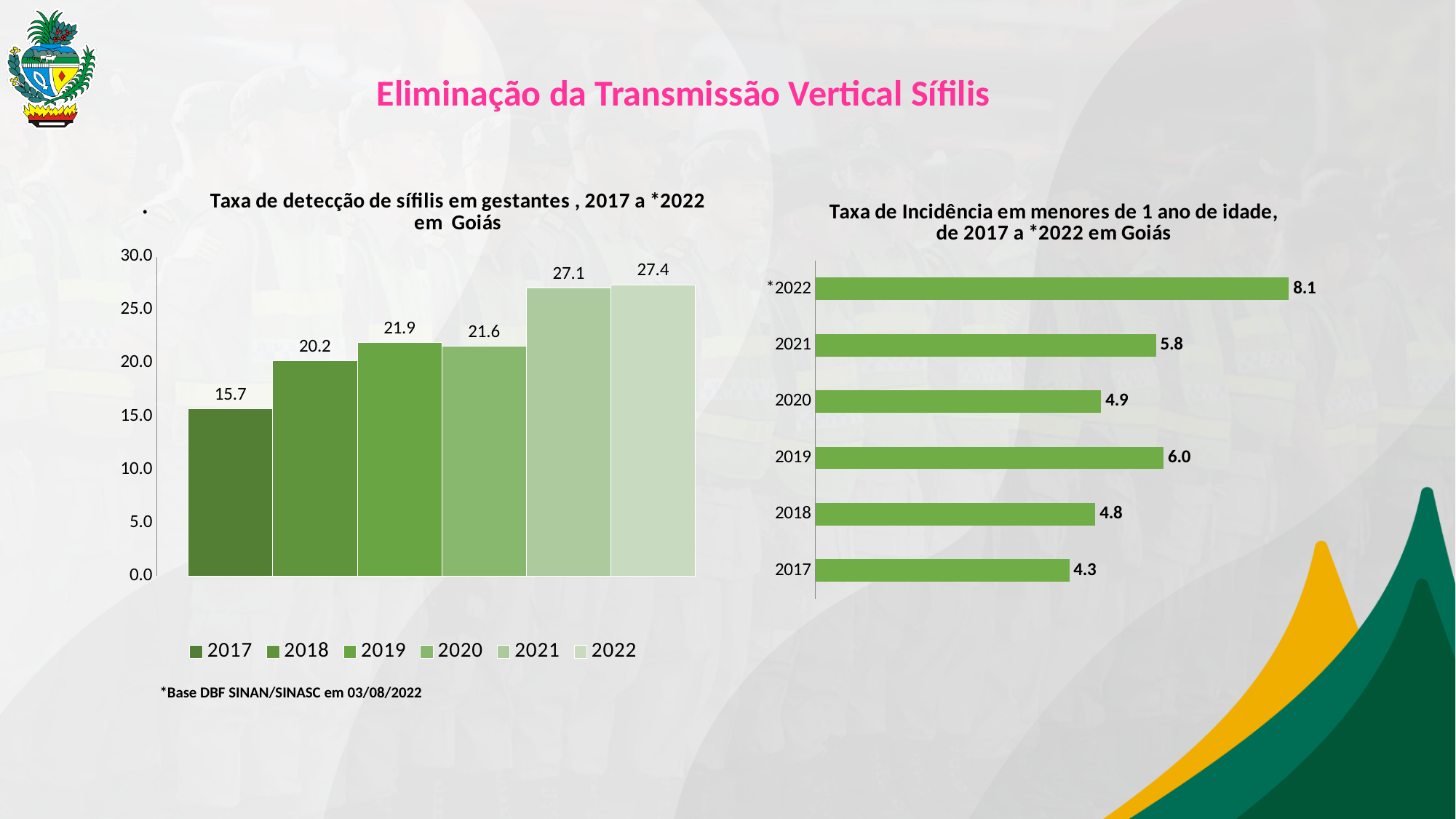
In the left chart (Taxa de detecção de sífilis em gestantes), which year has the highest value? 2022 In the left chart (Taxa de detecção de sífilis em gestantes), what is the difference between the 2022 value and the 2017 value? 11.7 What type of chart is the right chart (Taxa de Incidência em menores de 1 ano de idade)? Bar chart In the left chart (Taxa de detecção de sífilis em gestantes), what is the value for 2017? 15.7 In the right chart (Taxa de Incidência em menores de 1 ano de idade), which is larger, the value for 2018 or the value for 2021? 2021 In the right chart (Taxa de Incidência em menores de 1 ano de idade), what is the value for 2019? 6.0 In the right chart (Taxa de Incidência em menores de 1 ano de idade), which year has the lowest value? 2017 In the left chart (Taxa de detecção de sífilis em gestantes), how many legend entries are listed? 6 In the left chart (Taxa de detecção de sífilis em gestantes), what is the value for 2020? 21.6 In the left chart (Taxa de detecção de sífilis em gestantes), which year has the lowest value? 2017 In the left chart (Taxa de detecção de sífilis em gestantes), what is the overall trend of the values from 2017 to 2022? Rising In the right chart (Taxa de Incidência em menores de 1 ano de idade), what is the value for *2022? 8.1